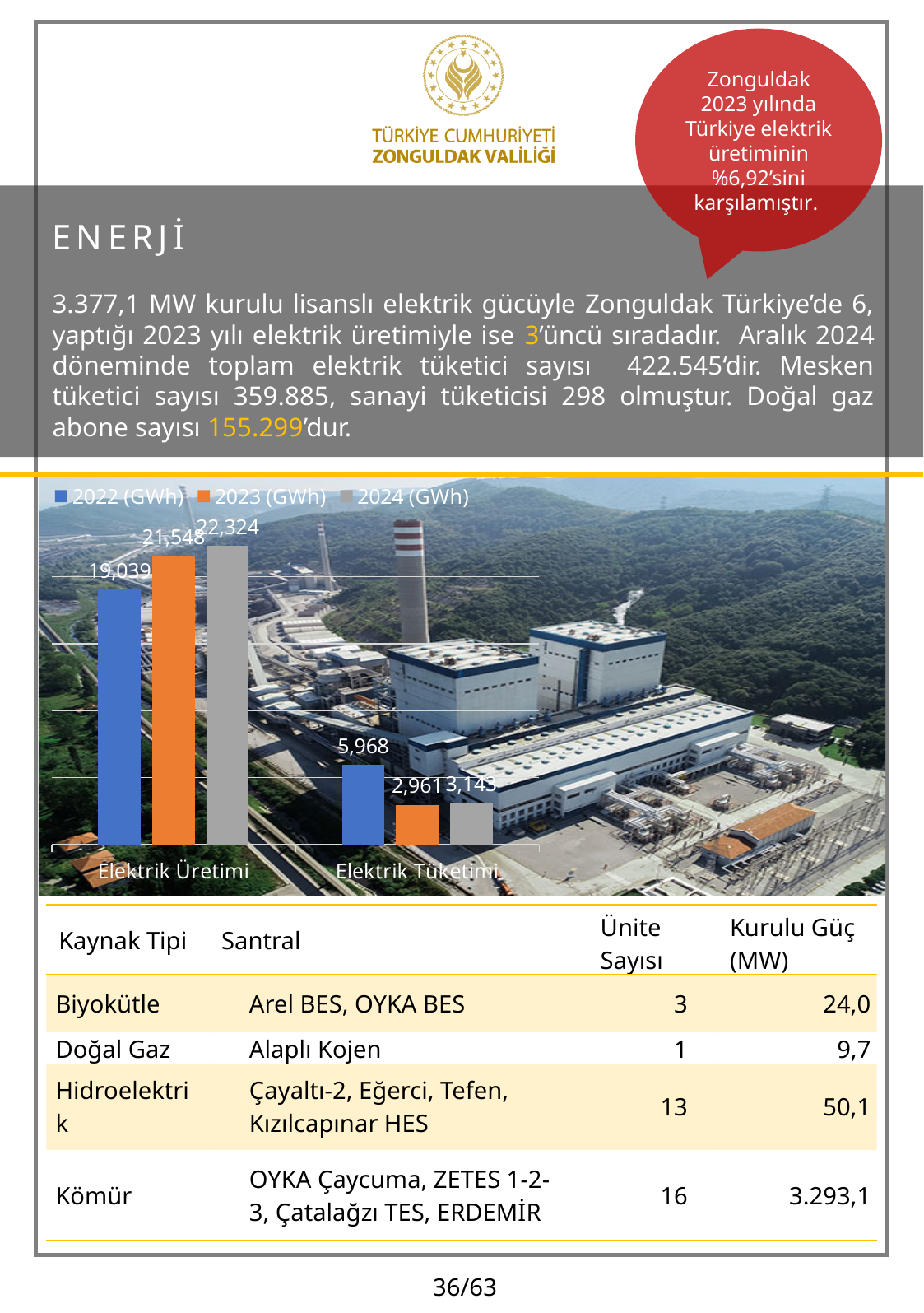
What is the 2024 (GWh) value for Elektrik Üretimi? 22,324 What is the 2022 (GWh) value for Elektrik Tüketimi? 5,968 Which year has the highest value for Elektrik Üretimi? 2024 (GWh) What is the 2023 (GWh) value for Elektrik Üretimi? 21,548 What is the difference between the 2024 and 2022 values for Elektrik Üretimi? 3,285 Which is larger: the 2022 value for Elektrik Tüketimi or the 2024 value for Elektrik Tüketimi? 2022 (GWh) What is the 2023 (GWh) value for Elektrik Tüketimi? 2,961 What type of chart is shown on the slide? bar chart Which year has the lowest value for Elektrik Tüketimi? 2023 (GWh) How many categories are shown on the x axis of the chart? 2 How many series does the chart legend list? 3 What is the 2022 (GWh) value for Elektrik Üretimi? 19,039